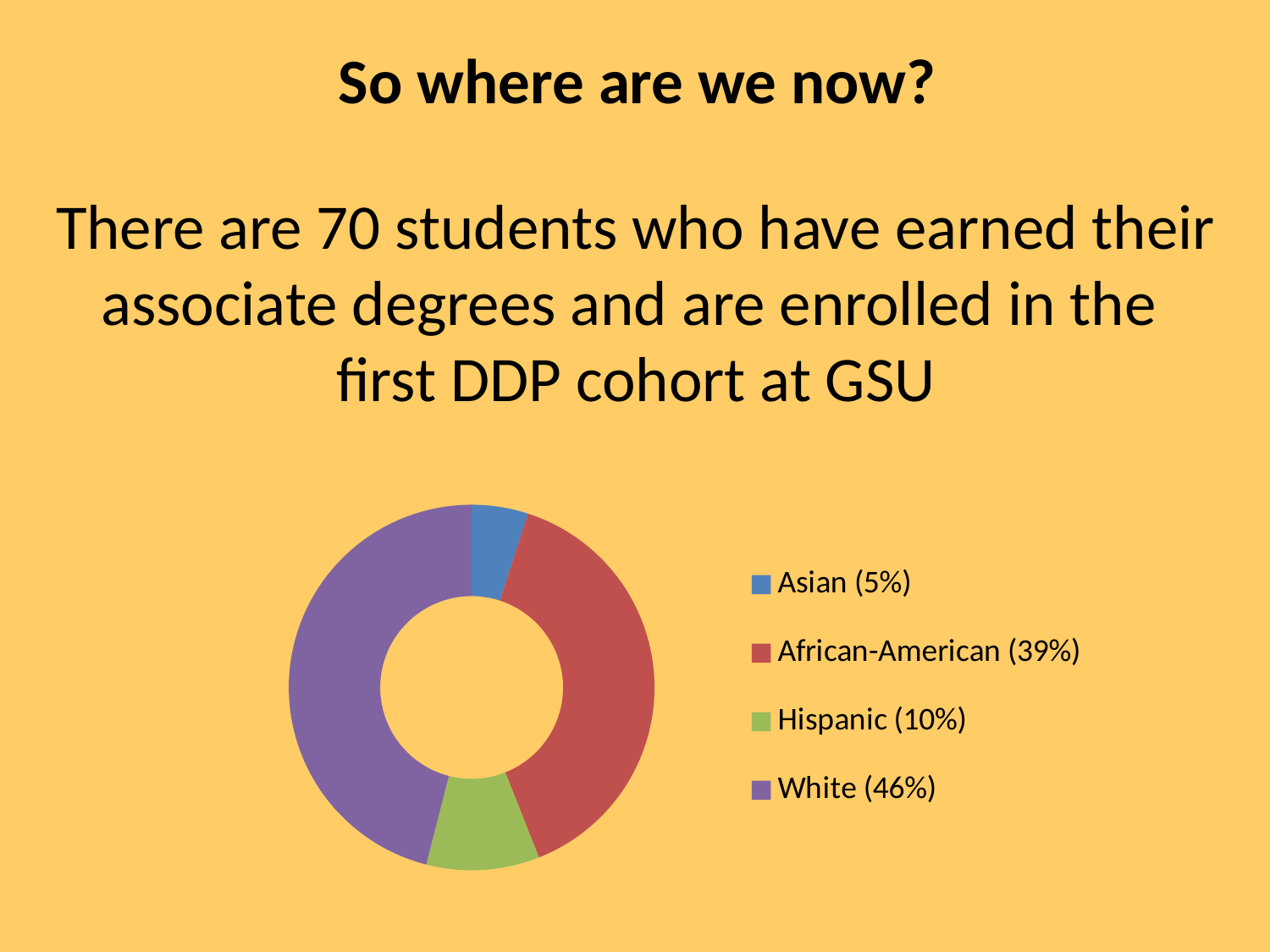
Which is larger, the Hispanic share or the Asian share? Hispanic What share of the doughnut chart is White? 46% What is the difference in percentage points between the White and African-American shares? 7 What colour represents African-American in the doughnut chart? Red What share of the doughnut chart is African-American? 39% How many categories does the doughnut chart show? 4 What kind of chart is shown on the slide? Doughnut chart Which category is shown in purple in the doughnut chart? White What share of the doughnut chart is Asian? 5% Which category has the largest share of the doughnut chart? White Which category has the smallest share of the doughnut chart? Asian